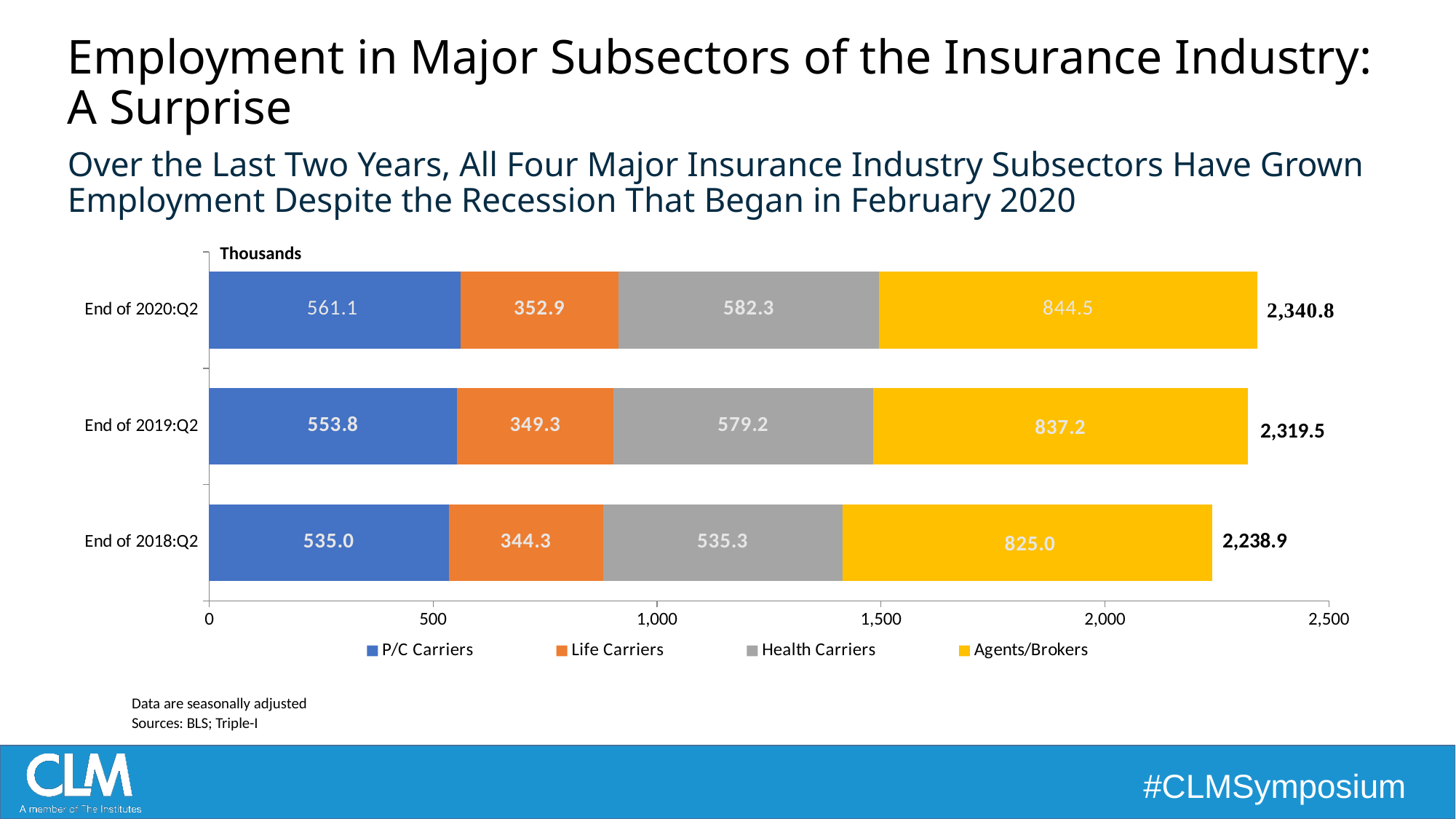
What is the value for Agents/Brokers at End of 2020:Q2? 844.5 What is the difference between the P/C Carriers values for End of 2020:Q2 and End of 2018:Q2? 26.1 What is the total of the stacked bar for End of 2020:Q2? 2,340.8 Which is larger at End of 2019:Q2: Health Carriers or P/C Carriers? Health Carriers What is the value for Life Carriers at End of 2018:Q2? 344.3 Which period has the highest total employment? End of 2020:Q2 What unit label is shown at the top of the chart's axis? Thousands What is the total of the stacked bar for End of 2018:Q2? 2,238.9 What kind of chart is shown on the slide? Stacked bar chart How many series does the legend list? 4 Which period has the lowest value for P/C Carriers? End of 2018:Q2 What is the value for Health Carriers at End of 2019:Q2? 579.2